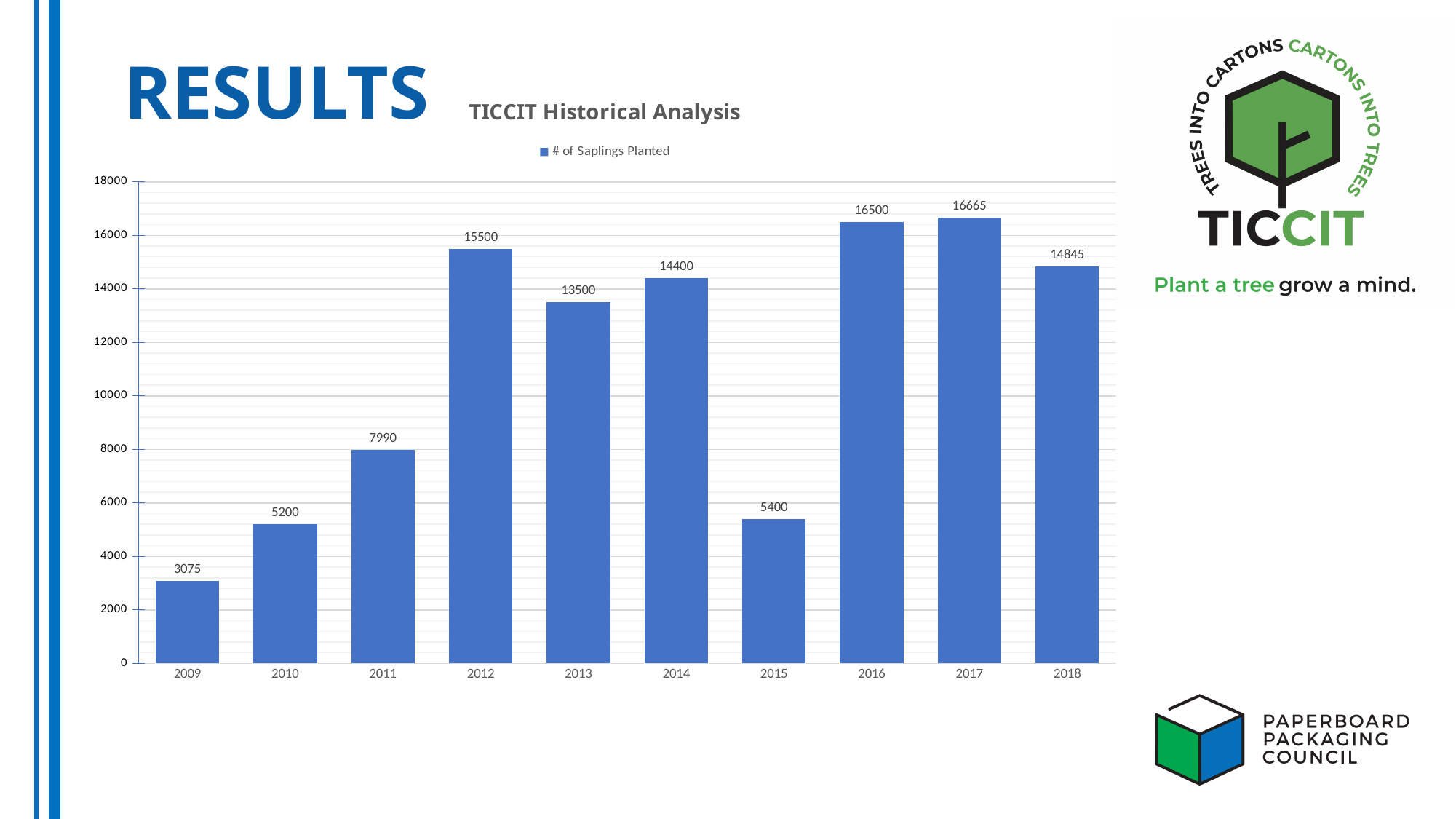
Is the value for 2014 greater or less than 14000? greater What is the value for 2009? 3075 What is the difference between the values for 2012 and 2013? 2000 Which year has the lowest number of saplings planted? 2009 What kind of chart is shown on the slide? Bar chart How many saplings were planted in 2018? 14845 What is the difference between the values for 2017 and 2016? 165 Which year has a larger value, 2011 or 2015? 2011 Which year has the highest number of saplings planted? 2017 How many saplings were planted in 2012? 15500 What is the title of the chart? TICCIT Historical Analysis How many years are shown on the x axis? 10